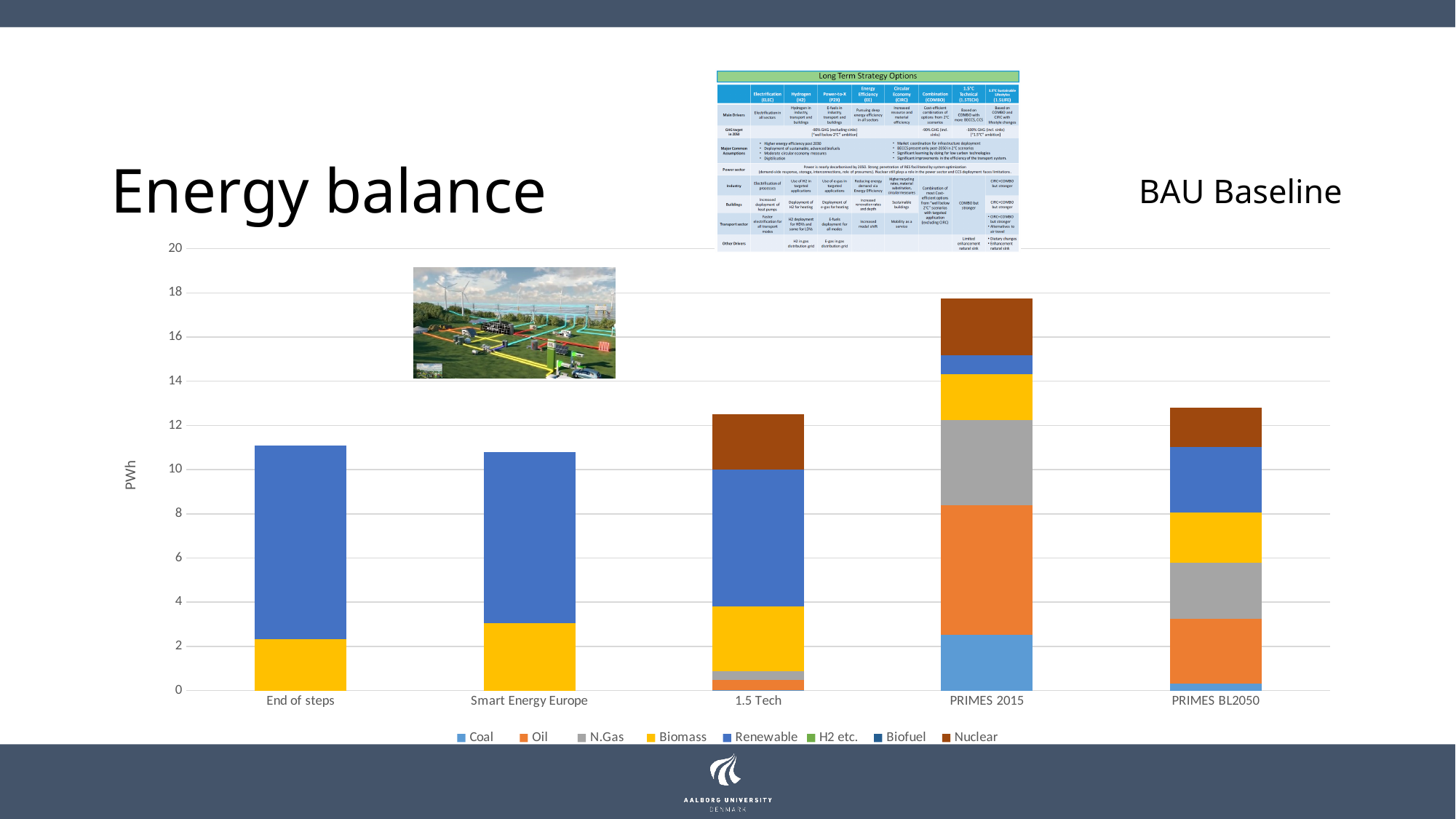
Which category has the largest Coal segment? PRIMES 2015 Which category has the tallest stacked bar? PRIMES 2015 Is the total for 1.5 Tech greater or less than 14? less Which has the larger total, 1.5 Tech or Smart Energy Europe? 1.5 Tech Is the total for End of steps greater or less than 10? greater How many series does the chart legend list? 8 Which has the larger total, PRIMES 2015 or PRIMES BL2050? PRIMES 2015 How many categories are shown on the x axis of the chart? 5 What kind of chart is shown on the slide? stacked bar chart Is the total for PRIMES 2015 greater or less than 16? greater What is the label on the vertical axis of the chart? PWh